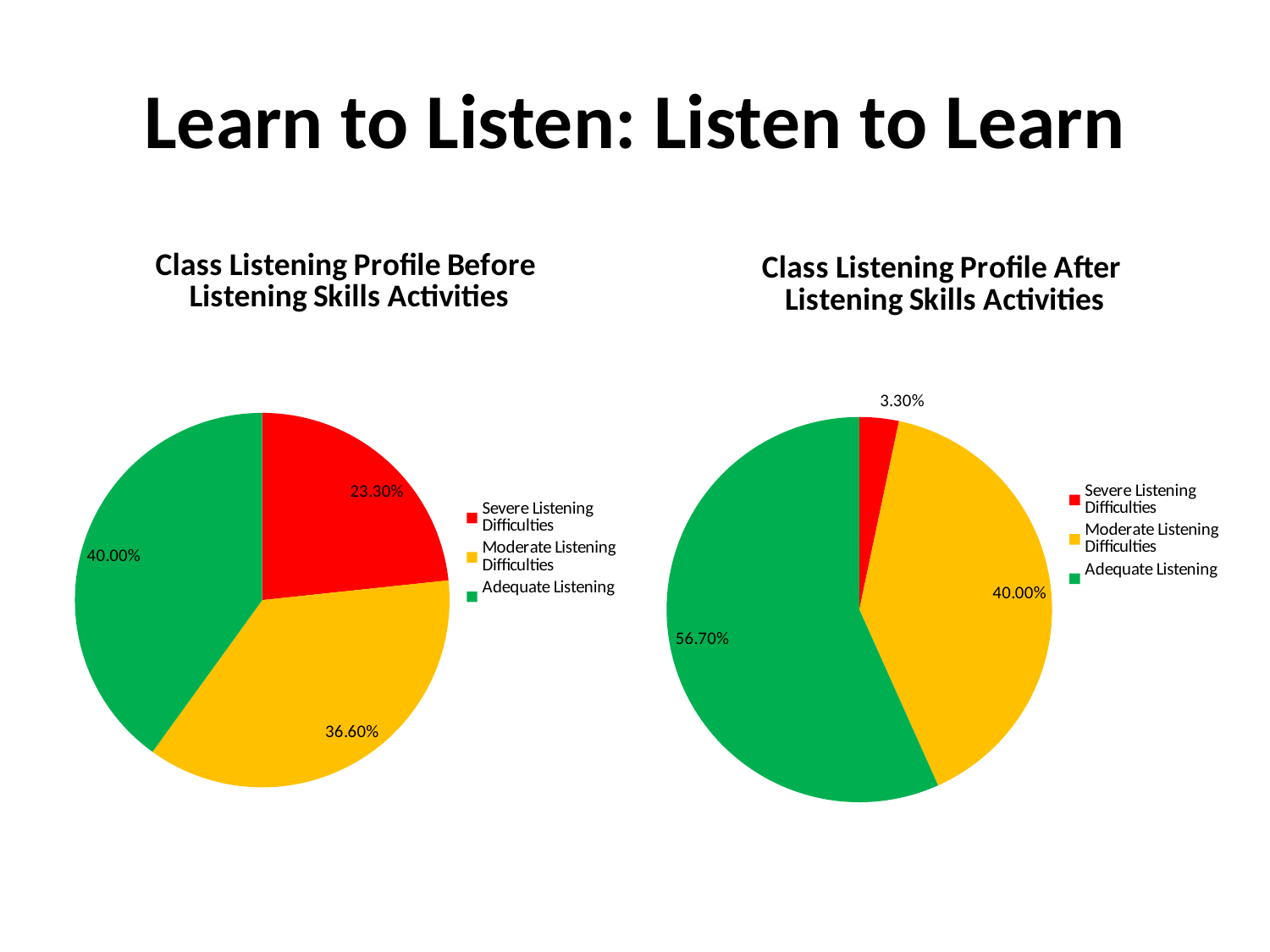
In the 'Class Listening Profile Before Listening Skills Activities' chart, which category has the largest share? Adequate Listening In the 'Class Listening Profile Before Listening Skills Activities' chart, which is larger: Moderate Listening Difficulties or Severe Listening Difficulties? Moderate Listening Difficulties In the 'Class Listening Profile Before Listening Skills Activities' chart, what percentage is shown for Moderate Listening Difficulties? 36.60% In the 'Class Listening Profile After Listening Skills Activities' chart, what percentage is shown for Severe Listening Difficulties? 3.30% How many slices does the 'Class Listening Profile After Listening Skills Activities' pie chart have? 3 In the 'Class Listening Profile After Listening Skills Activities' chart, what colour represents Adequate Listening? Green In the 'Class Listening Profile After Listening Skills Activities' chart, what percentage is shown for Adequate Listening? 56.70% What type of chart is used for 'Class Listening Profile Before Listening Skills Activities'? Pie chart In the 'Class Listening Profile After Listening Skills Activities' chart, which category has the smallest share? Severe Listening Difficulties In the 'Class Listening Profile Before Listening Skills Activities' chart, which category has the smallest share? Severe Listening Difficulties In the 'Class Listening Profile After Listening Skills Activities' chart, what is the difference between the Adequate Listening share and the Moderate Listening Difficulties share? 16.70% In the 'Class Listening Profile Before Listening Skills Activities' chart, what percentage is shown for Severe Listening Difficulties? 23.30%